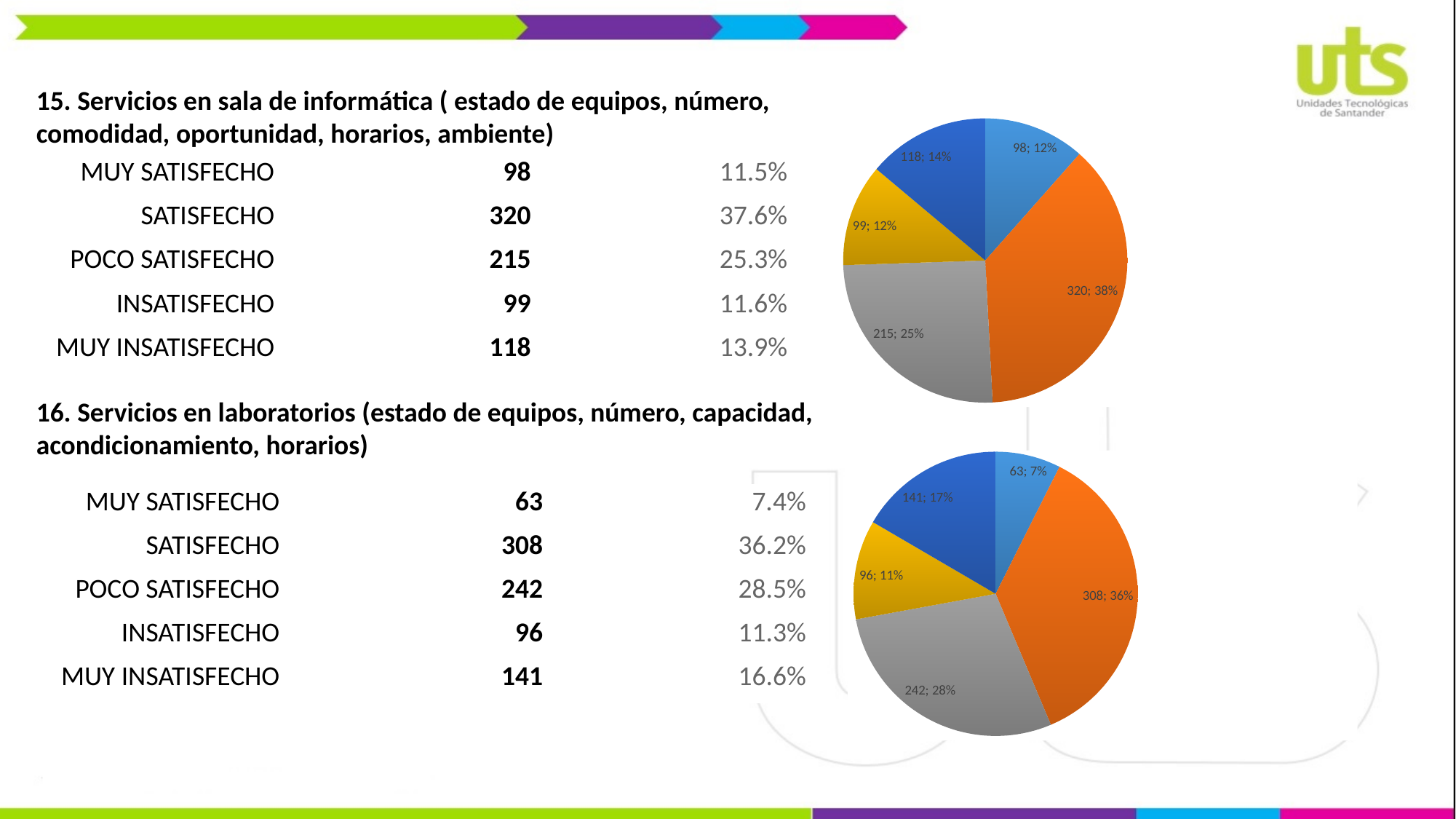
In the top pie chart, what is the difference between the slice valued 215 and the slice valued 118? 97 What kind of chart is the top chart on the slide? pie chart How many pie charts are shown on the slide? 2 In the bottom pie chart, what is the difference between the slice valued 308 and the slice valued 242? 66 In the bottom pie chart, what percentage is shown for the slice with value 242? 28% In the top pie chart, which slice is the smallest? 98; 12% In the top pie chart, which slice is the largest? 320; 38% In the top pie chart, what percentage is shown for the slice with value 320? 38% In the bottom pie chart, which slice is the largest? 308; 36% In the bottom pie chart, which is larger: the slice valued 141 or the slice valued 96? 141 In the bottom pie chart, which slice is the smallest? 63; 7% How many slices does the top pie chart have? 5